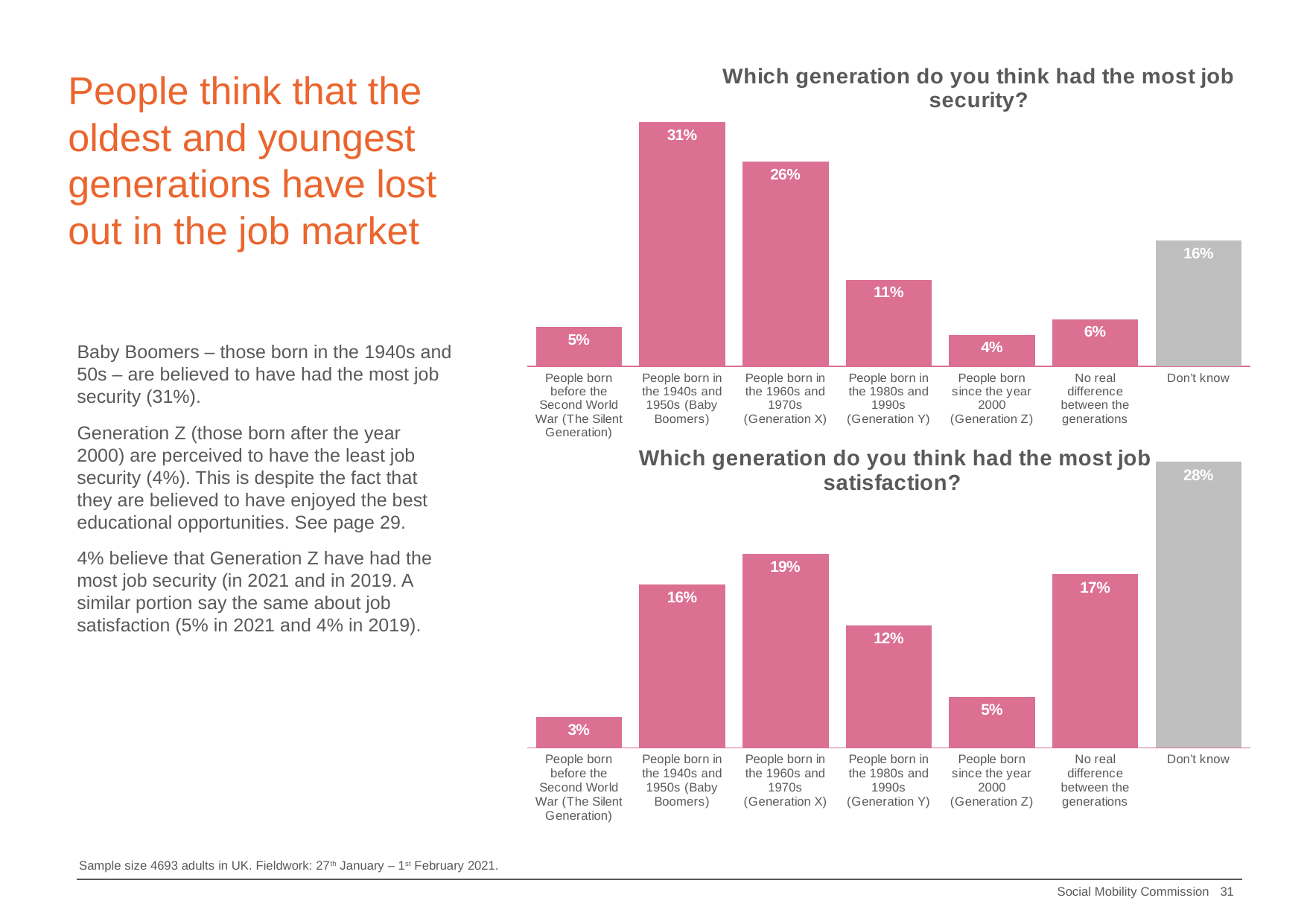
In the 'Which generation do you think had the most job security?' chart, which bar is coloured grey rather than pink? Don't know In the 'Which generation do you think had the most job satisfaction?' chart, what percentage is shown for People born in the 1960s and 1970s (Generation X)? 19% In the 'Which generation do you think had the most job satisfaction?' chart, which category has the lowest value? People born before the Second World War (The Silent Generation) In the 'Which generation do you think had the most job satisfaction?' chart, which is larger: the value for Baby Boomers or the value for No real difference between the generations? No real difference between the generations In the 'Which generation do you think had the most job satisfaction?' chart, what is the difference between the values for Generation Y and Generation Z? 7% In the 'Which generation do you think had the most job security?' chart, what percentage is shown for Don't know? 16% What type of chart is the 'Which generation do you think had the most job satisfaction?' chart? Bar chart In the 'Which generation do you think had the most job satisfaction?' chart, which category has the highest value? Don't know How many categories are shown in the 'Which generation do you think had the most job security?' chart? 7 In the 'Which generation do you think had the most job security?' chart, what is the difference between the values for Baby Boomers and Generation X? 5% In the 'Which generation do you think had the most job security?' chart, what percentage is shown for People born in the 1940s and 1950s (Baby Boomers)? 31% In the 'Which generation do you think had the most job security?' chart, which category has the lowest value? People born since the year 2000 (Generation Z)